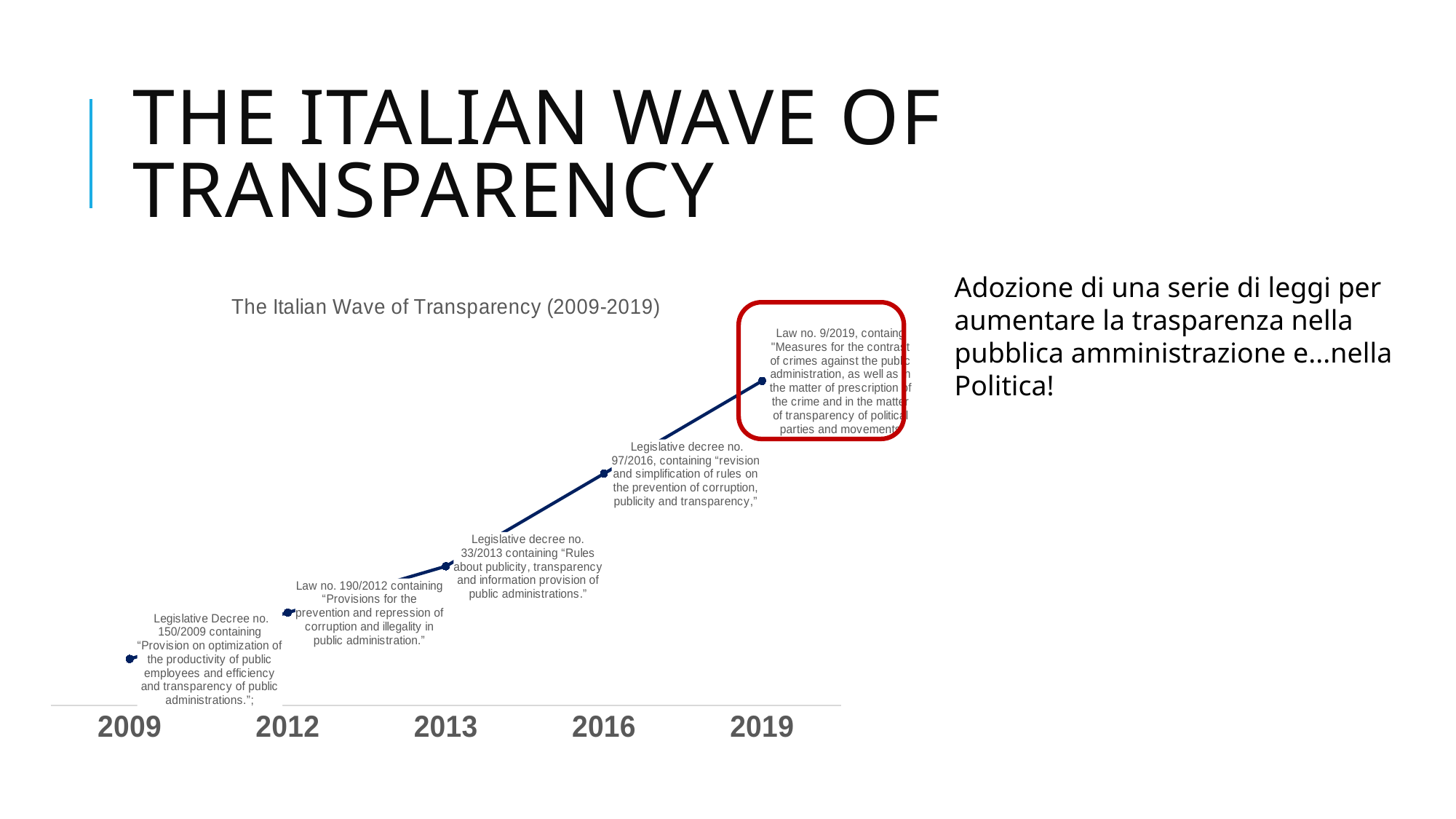
Which point is higher on the chart, 2013 or 2016? 2016 Which year has the highest point on the chart? 2019 Which law number is labelled at the 2012 point? Law no. 190/2012 What is the first year shown on the x axis? 2009 Which year's data label is highlighted with a red rounded box? 2019 Which legislative decree number is labelled at the 2016 point? Legislative decree no. 97/2016 Do the plotted values rise or fall from 2009 to 2019 along the x axis? rise What is the title of the chart? The Italian Wave of Transparency (2009-2019) How many data points are plotted on the chart? 5 What kind of chart is shown on the slide? line chart Which year has the lowest point on the chart? 2009 Which legislative decree number is labelled at the 2009 point? Legislative Decree no. 150/2009